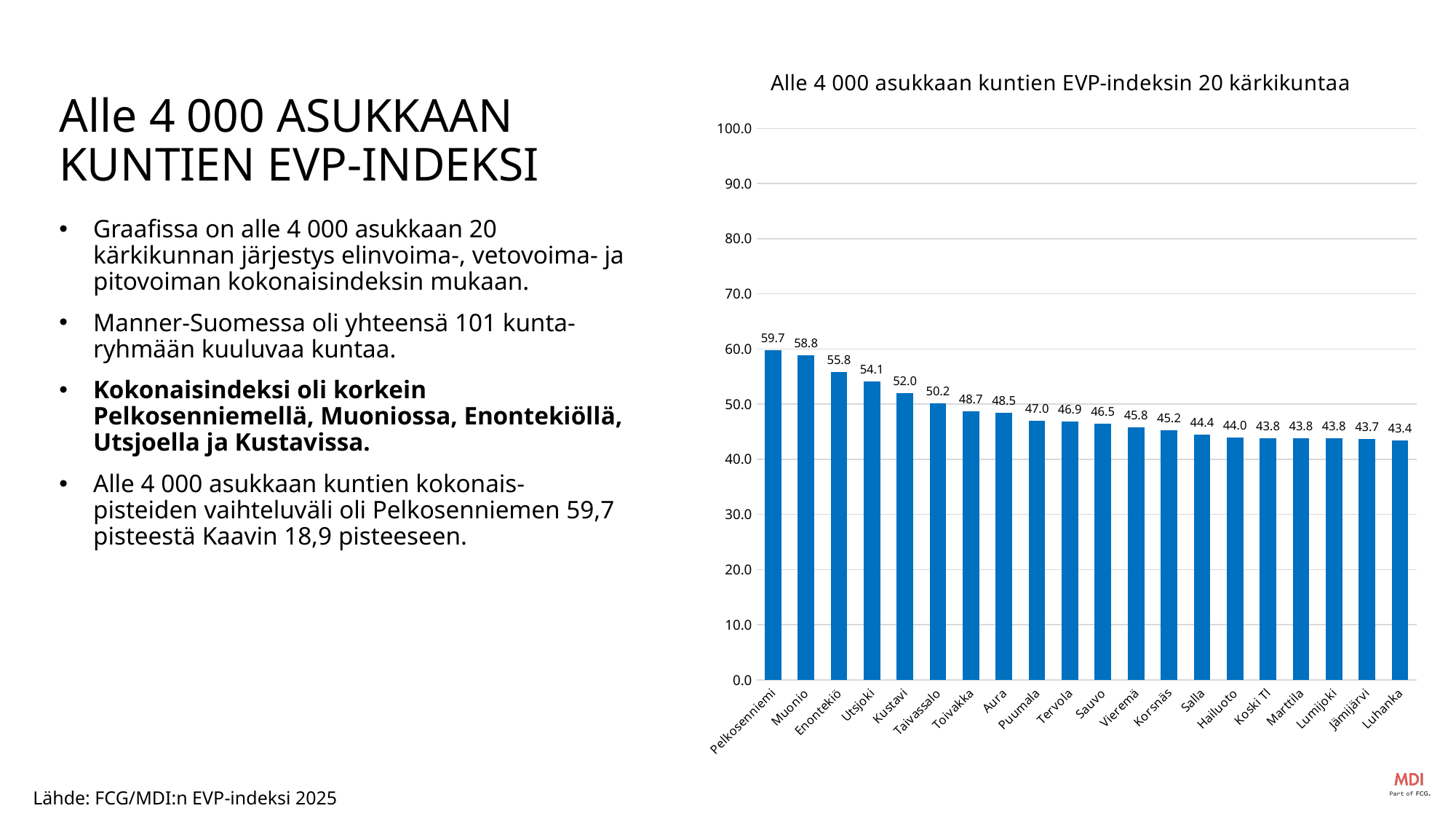
What is the title of the chart? Alle 4 000 asukkaan kuntien EVP-indeksin 20 kärkikuntaa What is the difference between the values for Enontekiö and Utsjoki? 1.7 What is the value for Salla? 44.4 What kind of chart is shown on the slide? bar chart How many municipalities are shown in the chart? 20 Is the value for Puumala greater or less than 50.0? less Which municipality has the lowest value in the chart? Luhanka Which has a larger value, Taivassalo or Toivakka? Taivassalo What is the value for Pelkosenniemi? 59.7 What is the value for Kustavi? 52.0 Which municipality has the highest value in the chart? Pelkosenniemi What is the difference between the values for Pelkosenniemi and Muonio? 0.9